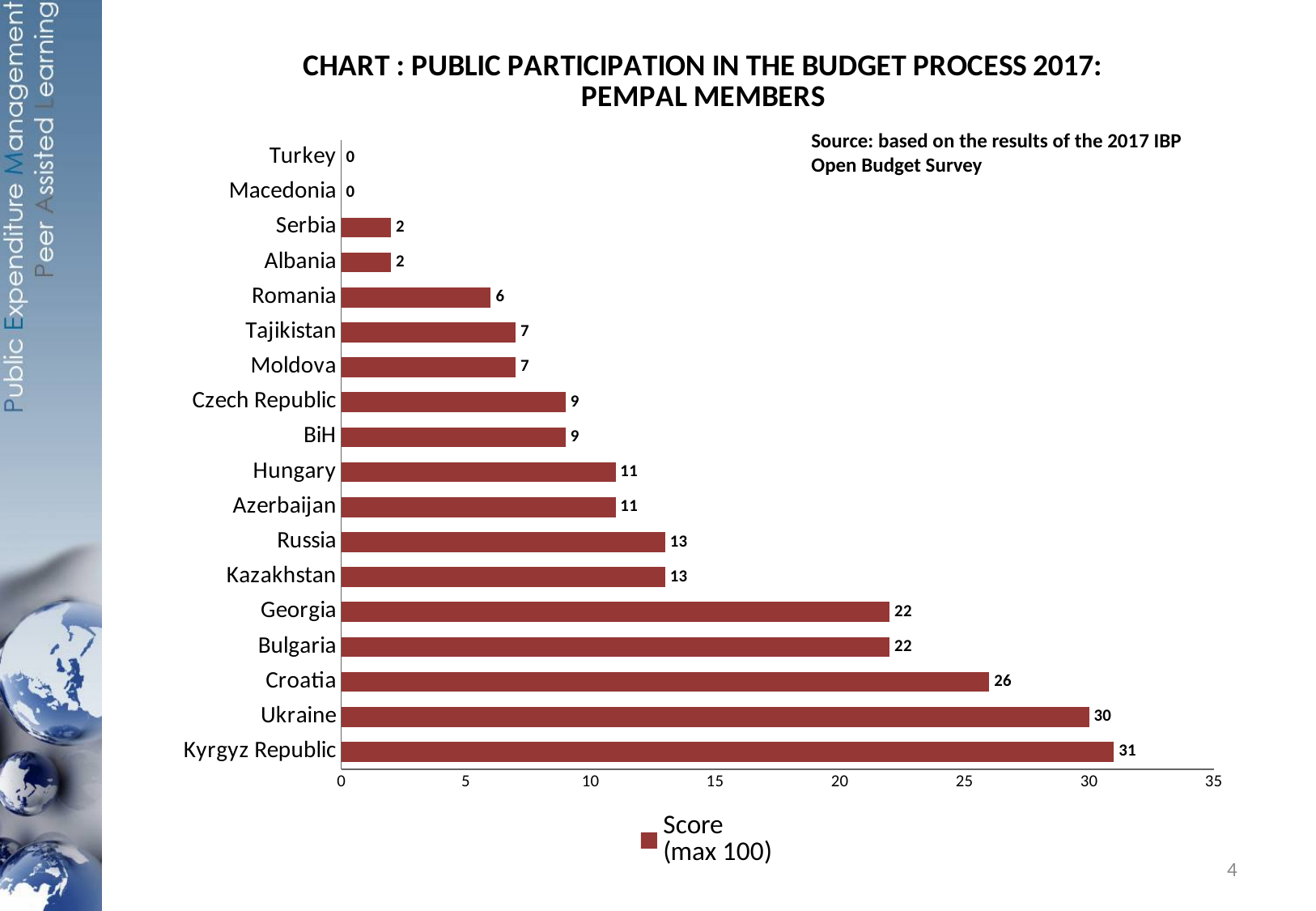
Which country has the highest score? Kyrgyz Republic Is the value for Croatia greater or less than 25? greater What is the score for Georgia? 22 Which countries have a score of 0? Turkey and Macedonia How many countries are shown in the chart? 18 What is the score for Kyrgyz Republic? 31 What is the legend entry for the series? Score (max 100) What is the difference between the scores of Ukraine and Croatia? 4 What kind of chart is shown? Bar chart What is the score for Romania? 6 How many series does the legend list? 1 Which has a higher score, Russia or Hungary? Russia